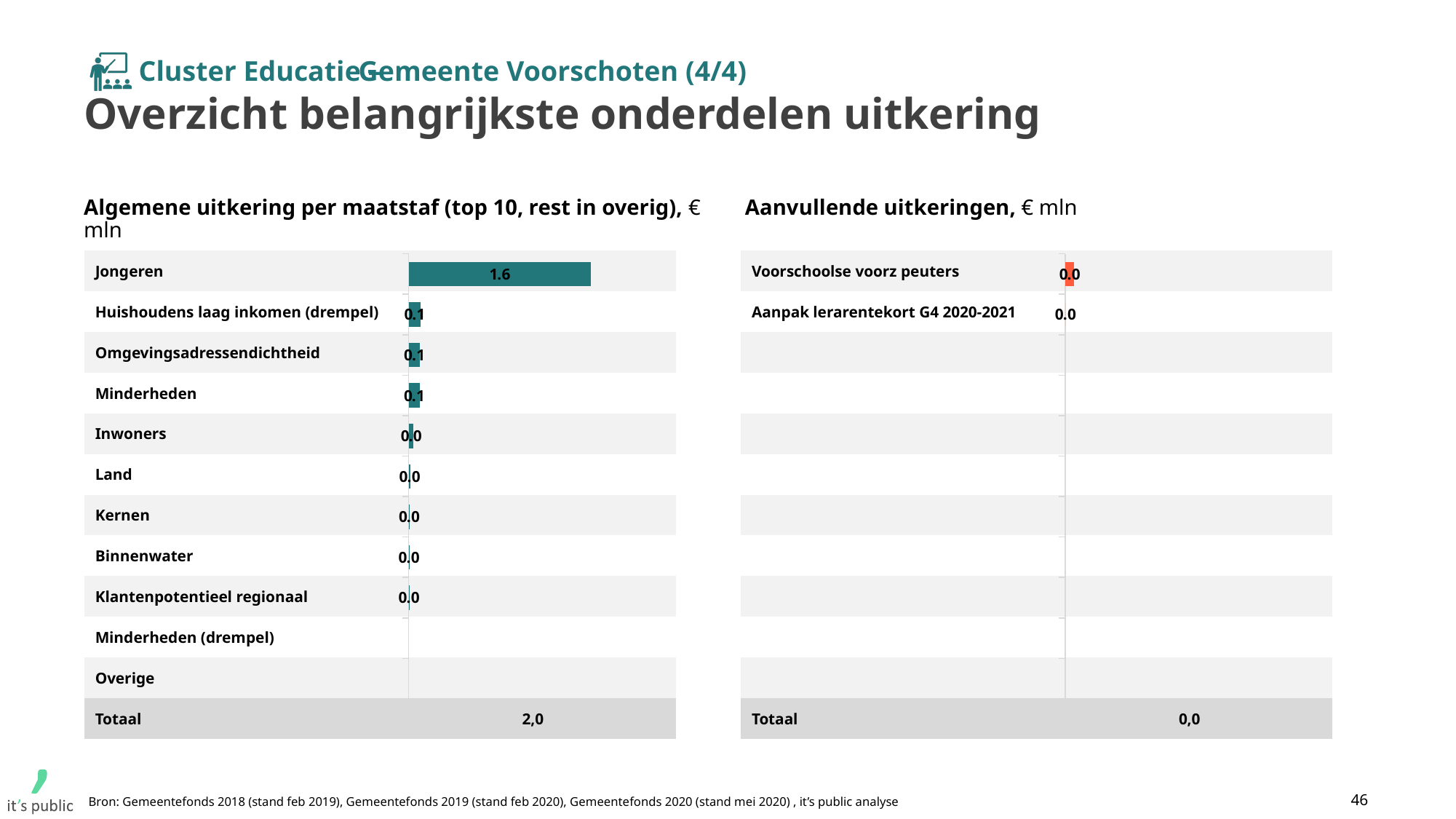
In the chart 'Algemene uitkering per maatstaf', what is the Totaal value shown? 2,0 How many categories (excluding Totaal) are listed in the chart 'Algemene uitkering per maatstaf'? 11 How many categories (excluding Totaal) are labelled in the chart 'Aanvullende uitkeringen'? 2 In the chart 'Algemene uitkering per maatstaf', what is the value for Jongeren? 1.6 In the chart 'Aanvullende uitkeringen', what is the Totaal value shown? 0,0 In the chart 'Aanvullende uitkeringen', what is the value for Voorschoolse voorz peuters? 0.0 What kind of chart is the 'Algemene uitkering per maatstaf' chart? bar chart In the chart 'Algemene uitkering per maatstaf', what is the value for Minderheden? 0.1 In the chart 'Algemene uitkering per maatstaf', what is the difference between the values for Jongeren and Huishoudens laag inkomen (drempel)? 1.5 In the chart 'Algemene uitkering per maatstaf', which category has the highest value? Jongeren In the chart 'Algemene uitkering per maatstaf', which is larger: Jongeren or Omgevingsadressendichtheid? Jongeren In the chart 'Algemene uitkering per maatstaf', what is the value for Inwoners? 0.0